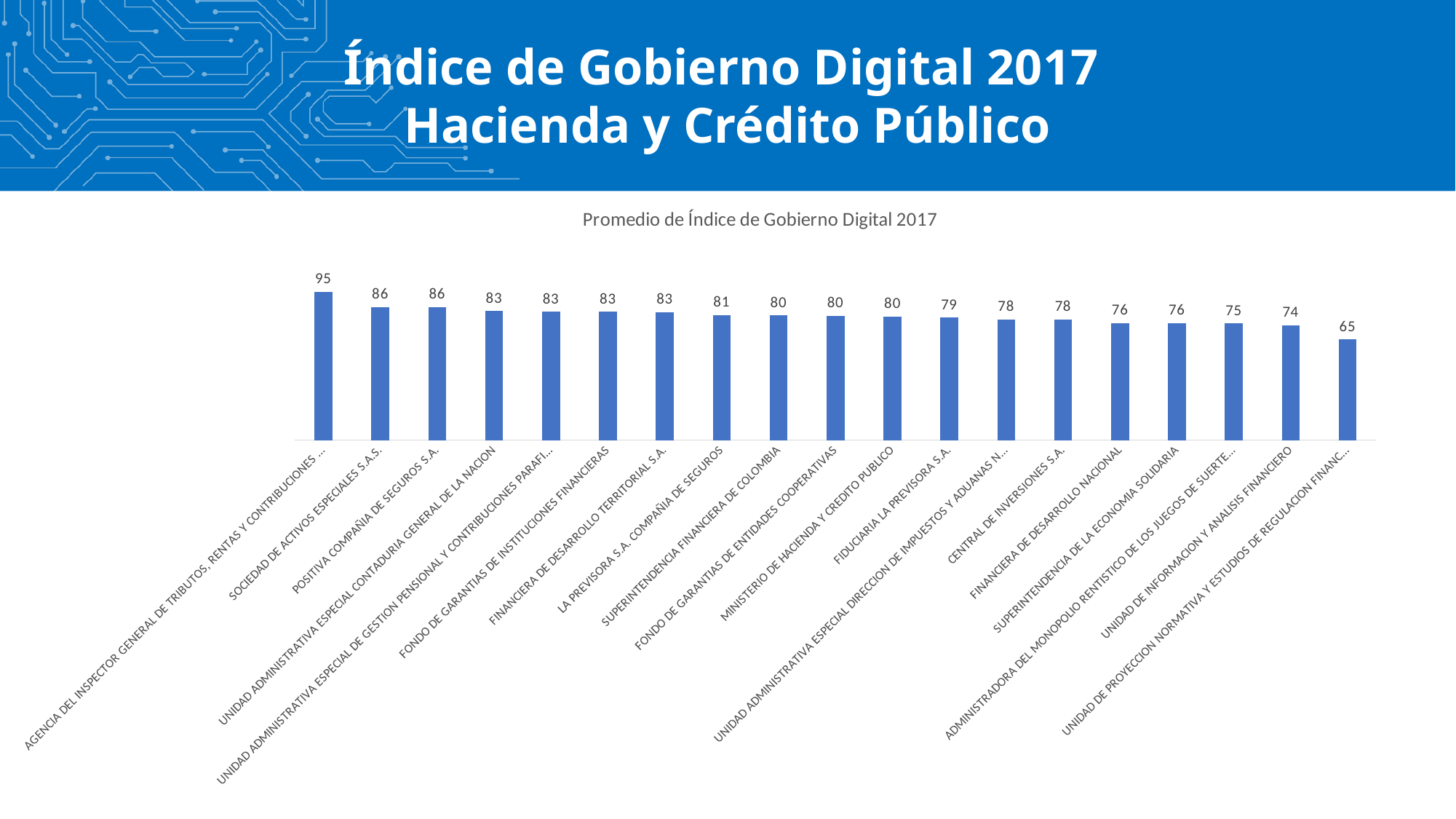
Which has a larger value, LA PREVISORA S.A. COMPAÑIA DE SEGUROS or CENTRAL DE INVERSIONES S.A.? LA PREVISORA S.A. COMPAÑIA DE SEGUROS Which entity has the lowest value in the chart? UNIDAD DE PROYECCION NORMATIVA Y ESTUDIOS DE REGULACION FINANCIERA What type of chart is shown on the slide? Bar chart What is the value for SOCIEDAD DE ACTIVOS ESPECIALES S.A.S.? 86 What is the difference between the highest value and the lowest value in the chart? 30 What is the value for UNIDAD DE INFORMACION Y ANALISIS FINANCIERO? 74 What is the value for FIDUCIARIA LA PREVISORA S.A.? 79 Which entity has the highest value in the chart? AGENCIA DEL INSPECTOR GENERAL DE TRIBUTOS, RENTAS Y CONTRIBUCIONES What is the title of the chart? Promedio de Índice de Gobierno Digital 2017 Do the values generally rise or fall from left to right across the chart? Fall How many entities (bars) are shown in the chart? 19 What is the value for MINISTERIO DE HACIENDA Y CREDITO PUBLICO? 80